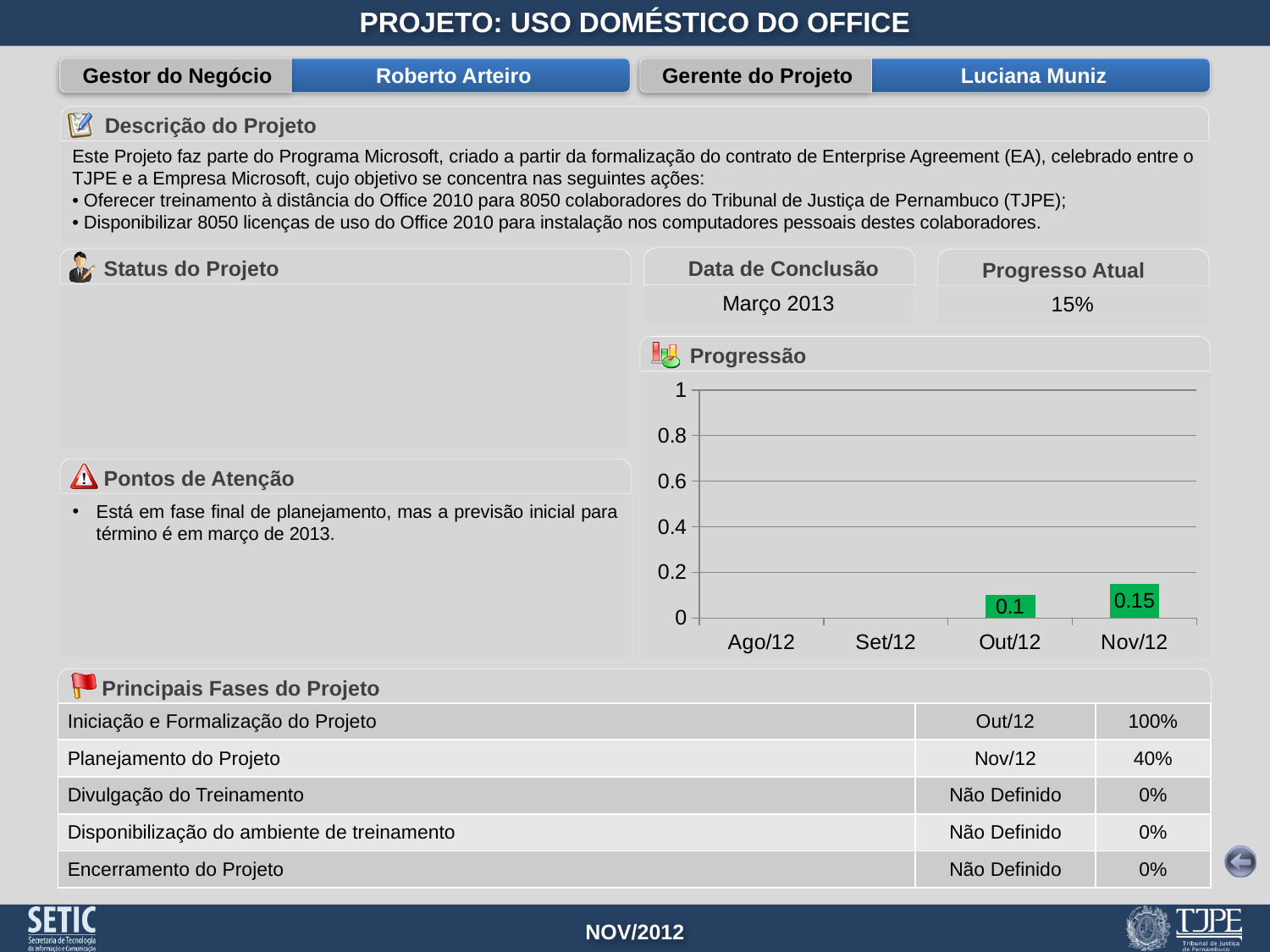
Is the value for Nov/12 in the Progressão chart greater or less than 0.2? less What is the difference between the Nov/12 and Out/12 values in the Progressão chart? 0.05 What is the value for Nov/12 in the Progressão chart? 0.15 In the Progressão chart, which is larger: the value for Out/12 or the value for Nov/12? Nov/12 What kind of chart is the Progressão chart? bar chart What is the value for Out/12 in the Progressão chart? 0.1 Do the values in the Progressão chart rise or fall from Out/12 to Nov/12? rise How many months are shown on the x axis of the Progressão chart? 4 Which month has the highest value in the Progressão chart? Nov/12 What is the maximum value shown on the y axis of the Progressão chart? 1 Which is the first month shown on the x axis of the Progressão chart? Ago/12 What colour are the bars in the Progressão chart? green